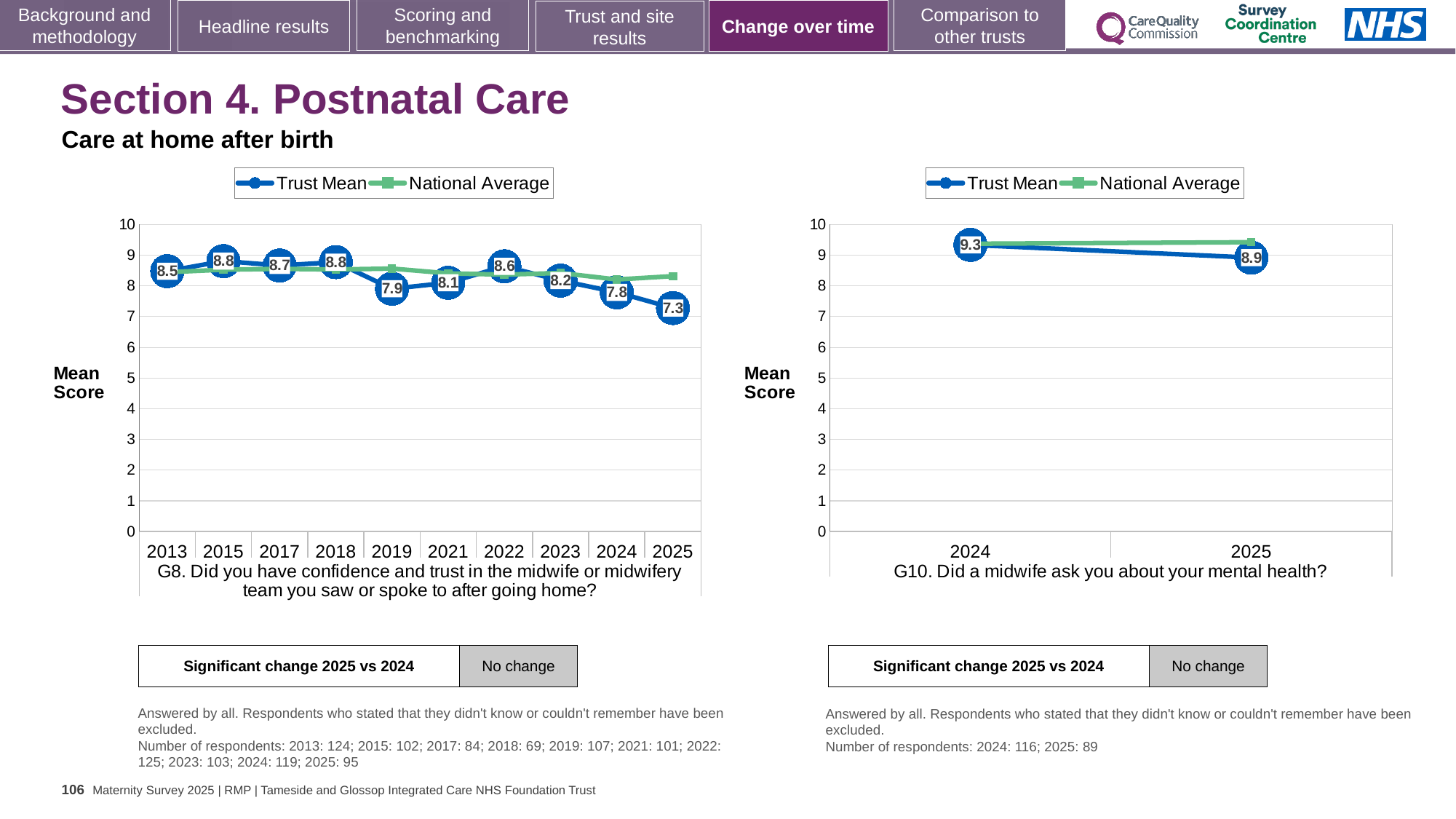
In the G10 chart on the right, what is the difference between the Trust Mean scores for 2024 and 2025? 0.4 In the G8 chart on the left, which year has the lowest Trust Mean score? 2025 In the G8 chart on the left, what is the Trust Mean score for 2019? 7.9 In the G10 chart on the right, does the Trust Mean rise or fall from 2024 to 2025? Fall In the G10 chart on the right, what is the Trust Mean score for 2024? 9.3 How many years are shown on the x axis of the G8 chart on the left? 10 In the G8 chart on the left, is the National Average value for 2025 greater or less than 8? greater In the G8 chart on the left, is the Trust Mean score higher in 2022 or in 2023? 2022 How many series does the legend of the G10 chart on the right list? 2 In the G8 chart on the left, what is the difference between the Trust Mean scores for 2024 and 2025? 0.5 What type of chart is the G10 chart on the right? Line chart In the G8 chart on the left, what is the Trust Mean score for 2025? 7.3